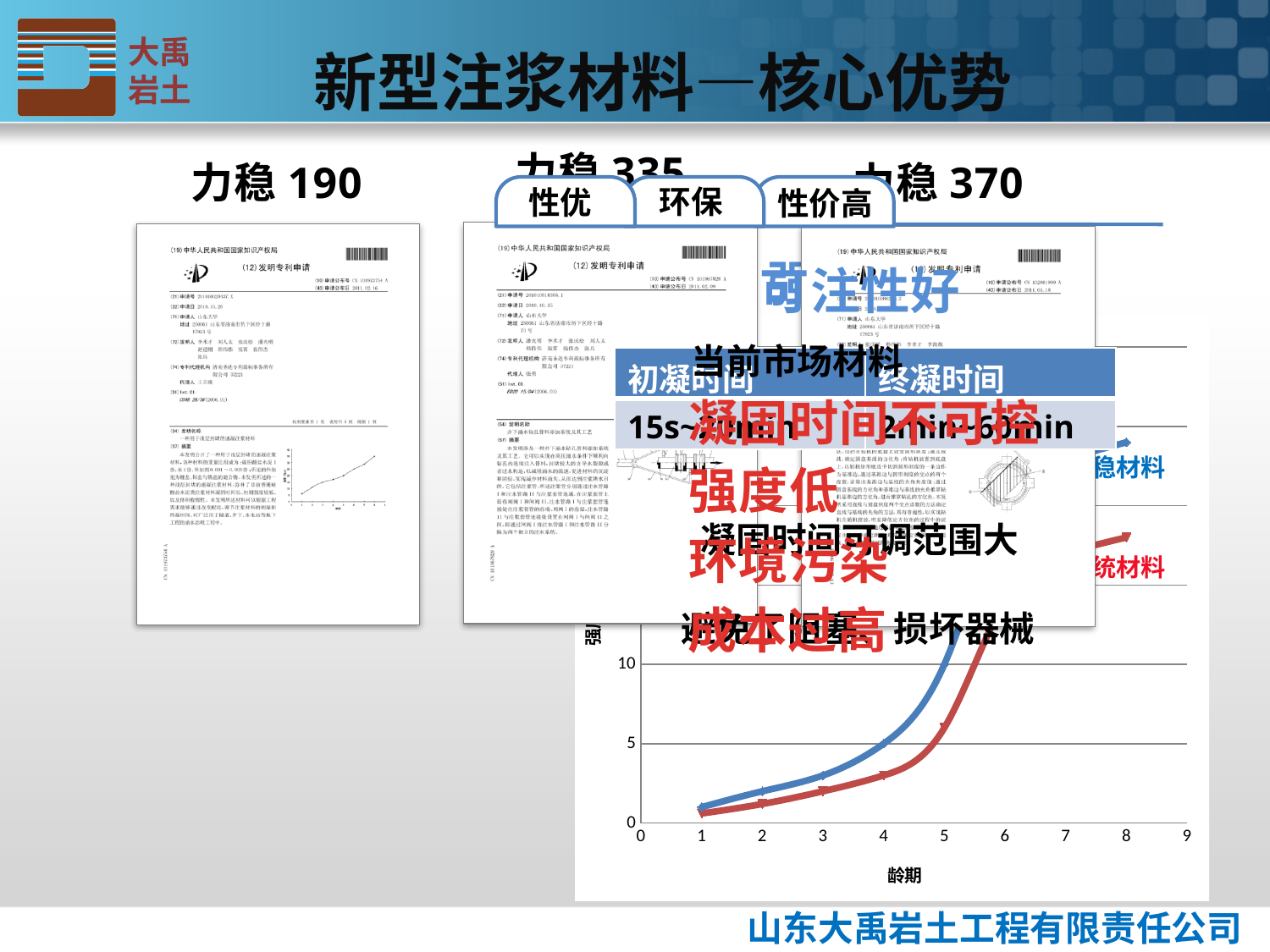
In the chart at the bottom right, which line has the higher value at 龄期 = 4, the blue line or the red line? the blue line How many lines (series) are plotted in the chart at the bottom right of the slide? 2 In the chart at the bottom right, do the plotted values rise or fall as 龄期 increases along the x axis? rise What kind of chart is shown at the bottom right of the slide? line chart In the chart at the bottom right, is the value of the red line at 龄期 = 5 greater or less than 5? greater In the chart at the bottom right, which line rises to higher values first as 龄期 increases, the blue line or the red line? the blue line In the chart at the bottom right, which line has the higher value at 龄期 = 5, the blue line or the red line? the blue line In the chart at the bottom right, is the value of the red line at 龄期 = 2 greater or less than 5? less In the chart at the bottom right, what is the largest value labelled on the x axis? 9 What is the x-axis title of the chart at the bottom right of the slide? 龄期 In the chart at the bottom right, is the value of the blue line at 龄期 = 1 greater or less than 5? less